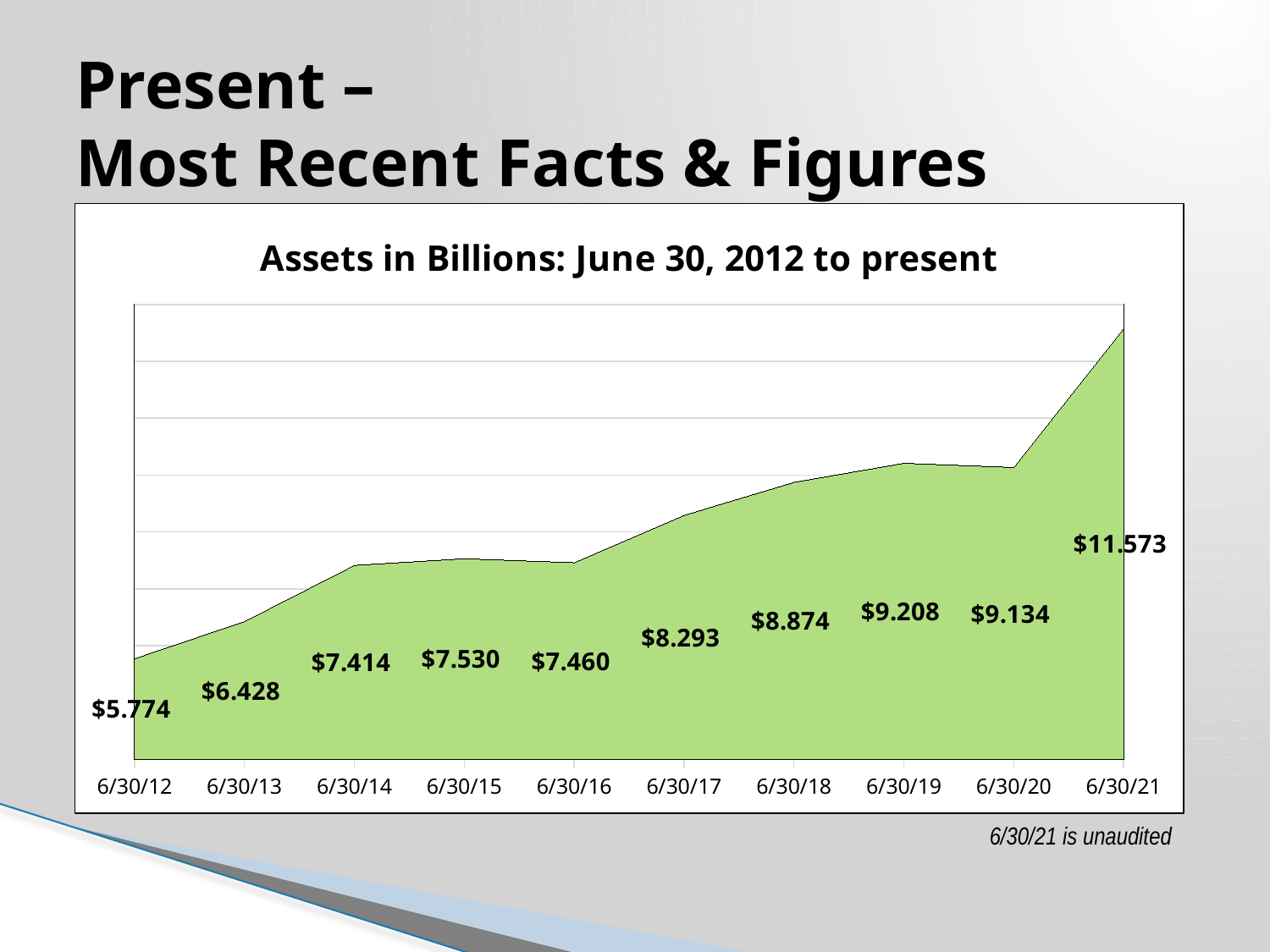
How many dates are plotted on the chart? 10 What is the title of the chart? Assets in Billions: June 30, 2012 to present What is the value for 6/30/17? $8.293 What is the value for 6/30/21? $11.573 What is the difference between the values for 6/30/21 and 6/30/20? $2.439 What kind of chart is shown? Area chart What is the value for 6/30/12? $5.774 Which is larger, the value for 6/30/19 or the value for 6/30/20? 6/30/19 Which is larger, the value for 6/30/15 or the value for 6/30/16? 6/30/15 What is the difference between the values for 6/30/13 and 6/30/12? $0.654 Which date has the highest value? 6/30/21 Which date has the lowest value? 6/30/12